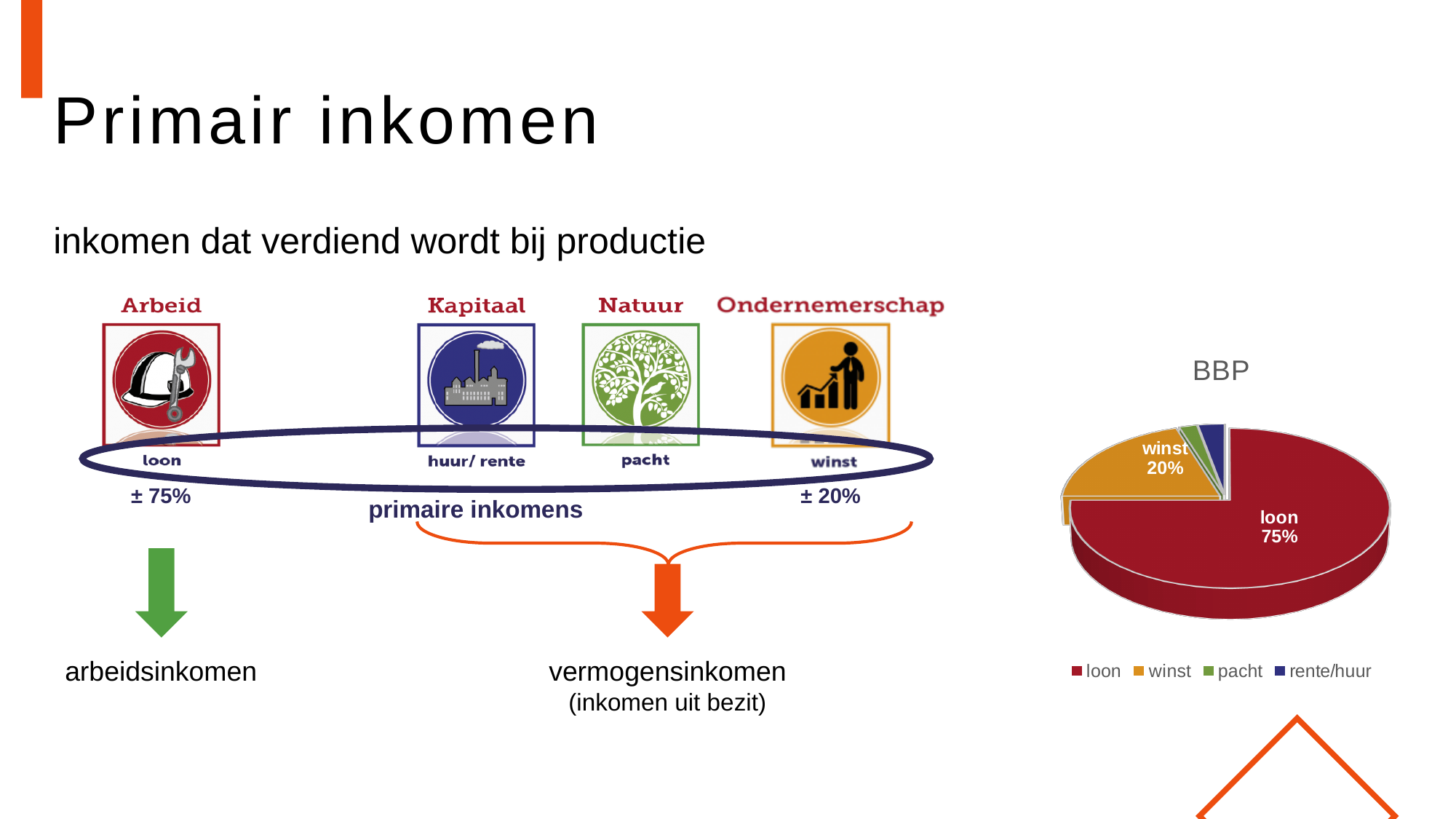
What share of the BBP pie does loon take? 75% Which slice is the largest in the BBP pie chart? loon Which is larger in the BBP pie chart, winst or pacht? winst What kind of chart is shown on the slide? pie chart What percentage does the winst slice represent in the BBP pie chart? 20% Which colour represents loon in the BBP pie chart? red What percentage does the loon slice represent in the BBP pie chart? 75% How many entries does the legend of the BBP pie chart list? 4 Which is larger in the BBP pie chart, loon or winst? loon What is the title of the pie chart? BBP What is the difference in percentage points between the loon and winst slices in the BBP pie chart? 55% How many slices does the BBP pie chart have? 4